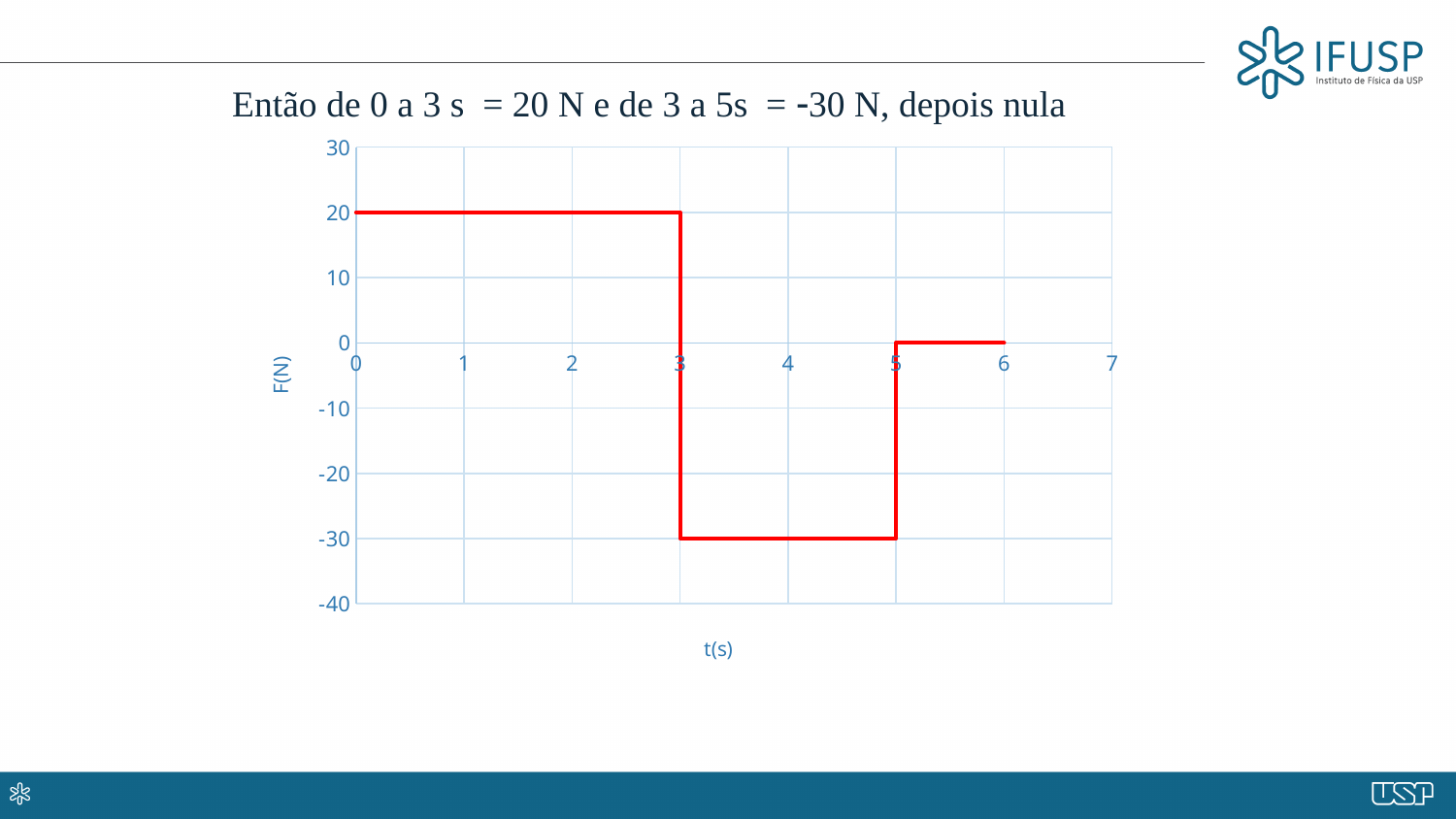
What is the value of F(N) between t = 3 s and t = 5 s? -30 What is the value of F(N) between t = 0 s and t = 3 s? 20 What type of chart is shown on the slide? line chart What is the label of the vertical axis? F(N) What is the label of the horizontal axis? t(s) Is the value of F(N) at t = 4 s greater or less than -20? less What is the lowest value of F(N) plotted on the chart? -30 Which is larger: the value of F(N) at t = 2 s or at t = 4 s? t = 2 s What is the difference between the value of F(N) from 0 to 3 s and the value from 3 to 5 s? 50 What is the value of F(N) between t = 5 s and t = 6 s? 0 What is the highest value of F(N) plotted on the chart? 20 Does the value of F(N) rise or fall at t = 3 s? fall